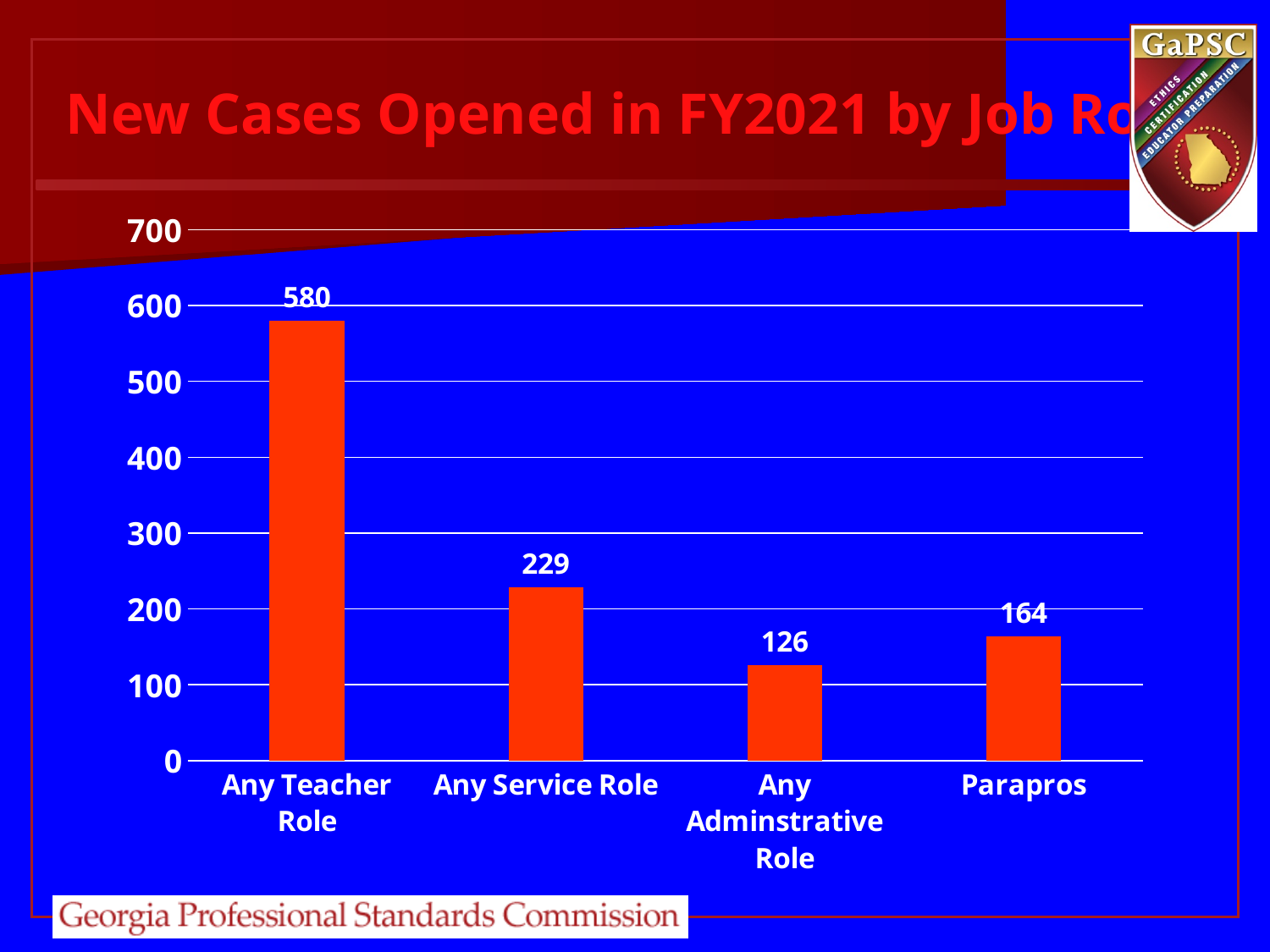
What kind of chart is shown on the slide? Bar chart Is the value for Any Teacher Role greater or less than 500? greater Which job role has the lowest number of new cases? Any Adminstrative Role What is the difference between the values for Parapros and Any Adminstrative Role? 38 Which is larger, the value for Any Service Role or the value for Parapros? Any Service Role What is the value for Any Adminstrative Role? 126 What is the difference between the values for Any Teacher Role and Any Service Role? 351 What is the value for Any Service Role? 229 How many job role categories are shown in the chart? 4 What is the value for Any Teacher Role? 580 What is the value for Parapros? 164 Which job role has the highest number of new cases? Any Teacher Role